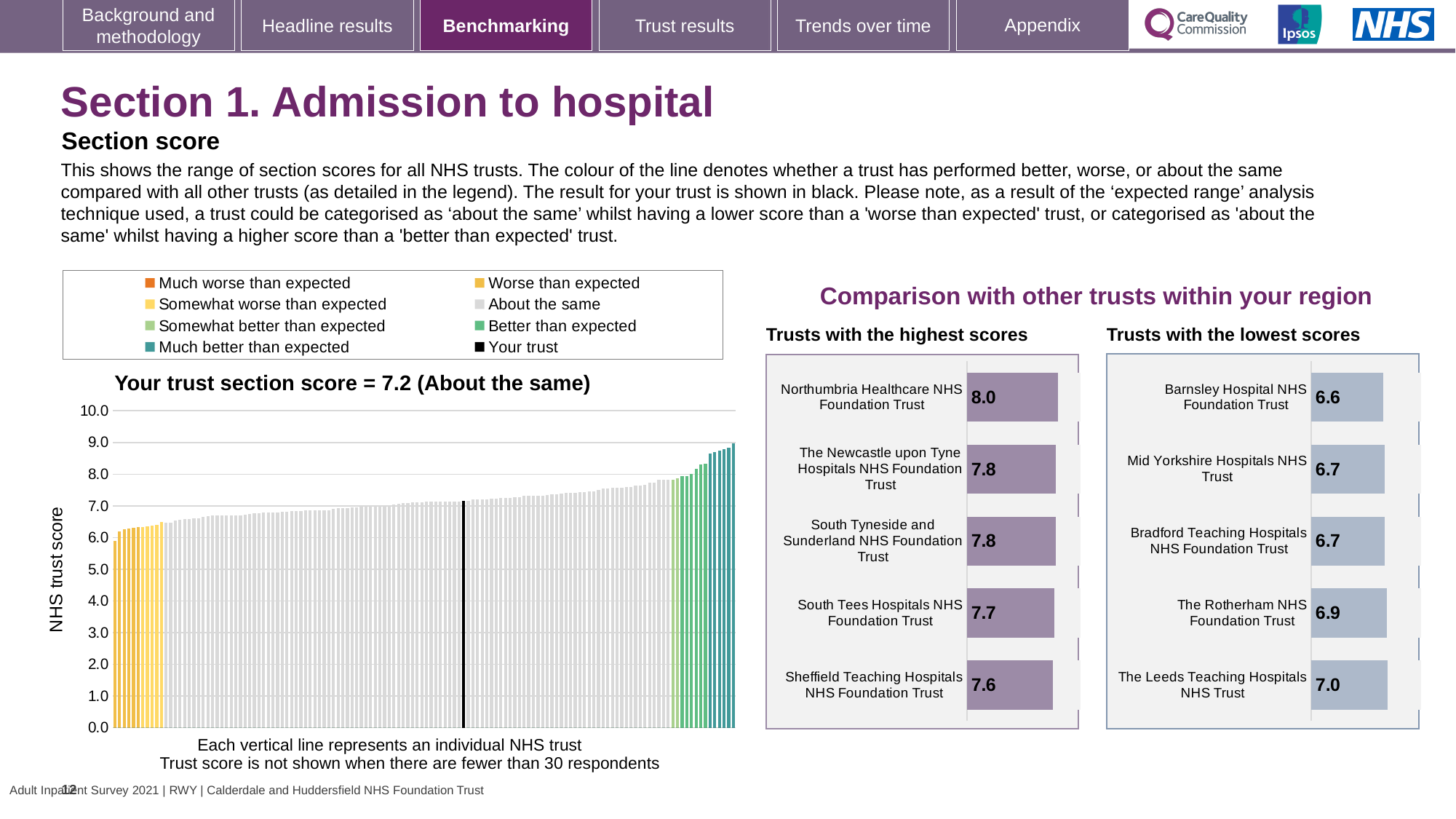
In the 'Trusts with the highest scores' chart, what is the difference between the scores of Northumbria Healthcare NHS Foundation Trust and Sheffield Teaching Hospitals NHS Foundation Trust? 0.4 In the 'Trusts with the highest scores' chart, which trust has the highest score? Northumbria Healthcare NHS Foundation Trust How many entries does the legend above the 'Your trust section score' chart list? 8 In the 'Your trust section score' chart, do the bars rise or fall from left to right? rise In the 'Trusts with the highest scores' chart, what is the score for Northumbria Healthcare NHS Foundation Trust? 8.0 In the 'Your trust section score' chart, is the value of the shortest bar greater or less than 7.0? less How many trusts are shown in the 'Trusts with the lowest scores' chart? 5 In the 'Your trust section score' chart, what is the section score for your trust? 7.2 What kind of chart is the 'Your trust section score' chart? bar chart In the 'Trusts with the lowest scores' chart, which has the higher score: The Rotherham NHS Foundation Trust or Mid Yorkshire Hospitals NHS Trust? The Rotherham NHS Foundation Trust In the 'Trusts with the lowest scores' chart, which trust has the lowest score? Barnsley Hospital NHS Foundation Trust In the 'Your trust section score' chart, is the value of the tallest bar greater or less than 8.0? greater